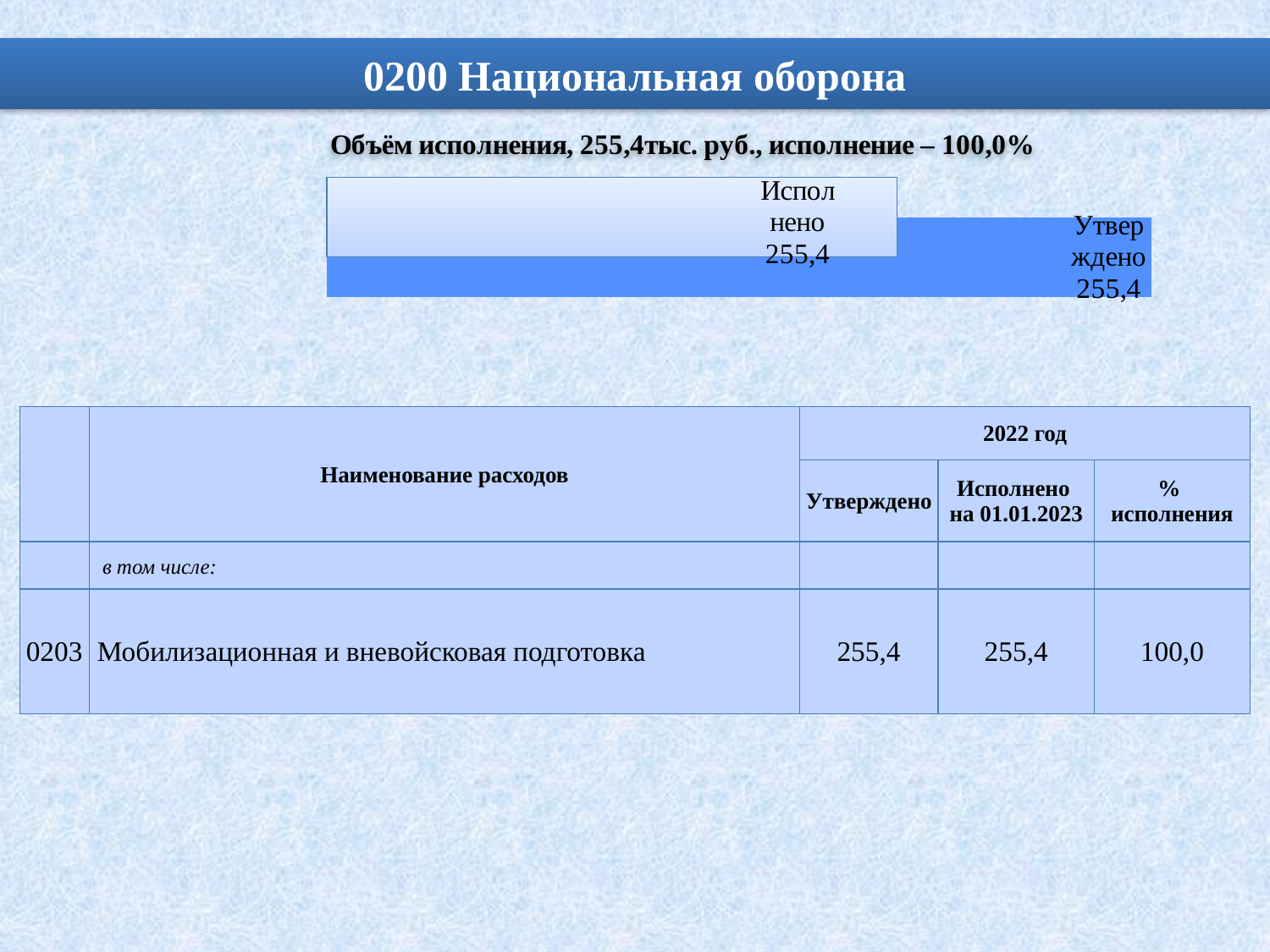
Are the bars in the chart oriented horizontally or vertically? horizontally What value is shown for the "Исполнено" bar in the chart? 255,4 Is the value for "Исполнено" in the chart greater or less than 200? greater Is the value for "Утверждено" in the chart greater or less than 300? less What kind of chart is shown on the slide? bar chart How many bars are plotted in the chart? 2 What is the difference between the "Утверждено" value and the "Исполнено" value in the chart? 0,0 What value is shown for the "Утверждено" bar in the chart? 255,4 Which bar in the chart is drawn in the darker blue colour? Утверждено